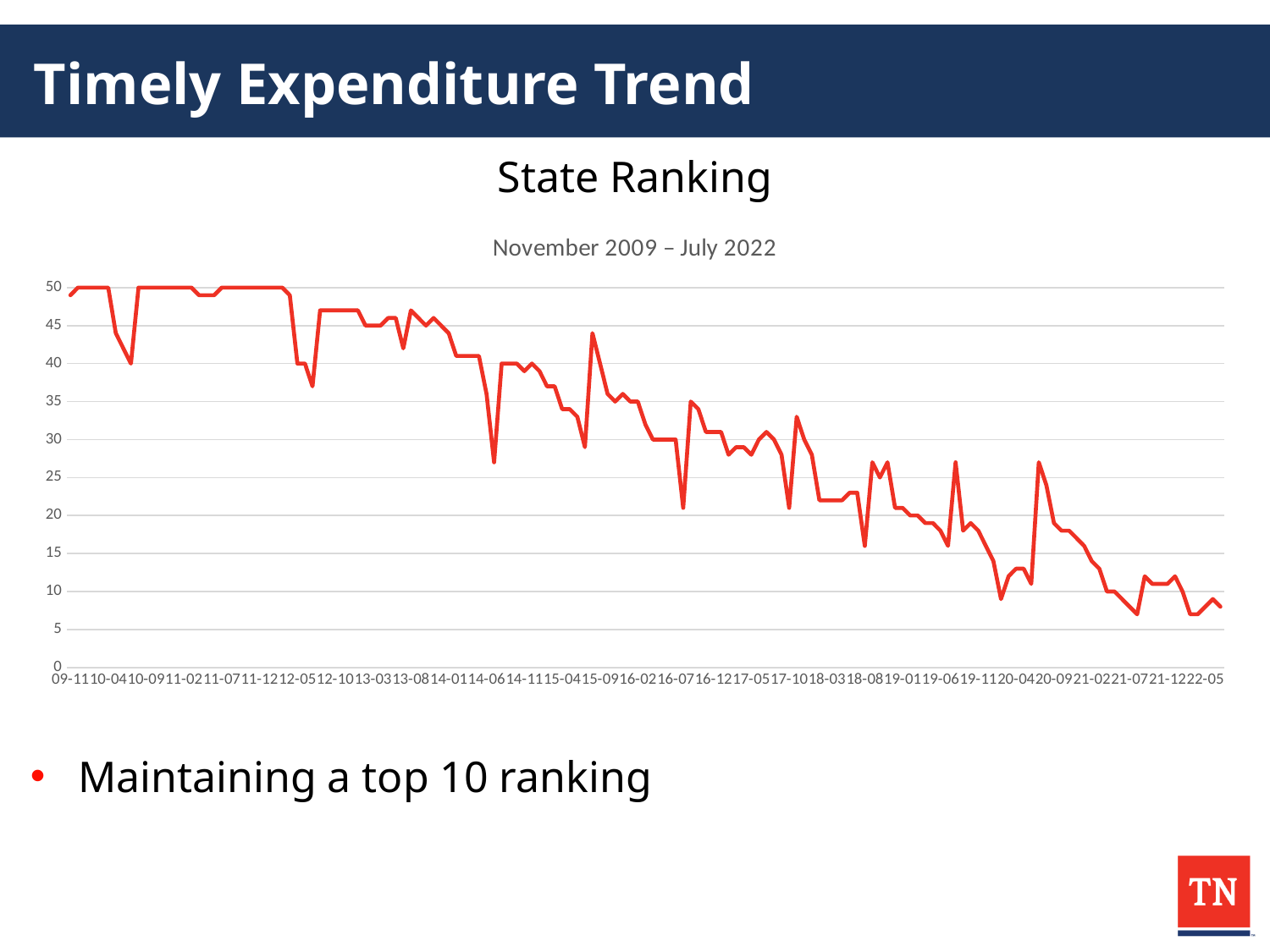
What date range does the chart title give? November 2009 – July 2022 Is the value for 11-07 greater or less than 45? greater Is the value for 18-03 greater or less than 25? less What is the highest value shown on the y axis? 50 Is the value for 16-02 greater or less than 25? greater Which is larger, the value for 10-04 or the value for 22-05? 10-04 What kind of chart is shown on the slide? line chart Do the state ranking values generally rise or fall from left to right along the x axis? fall